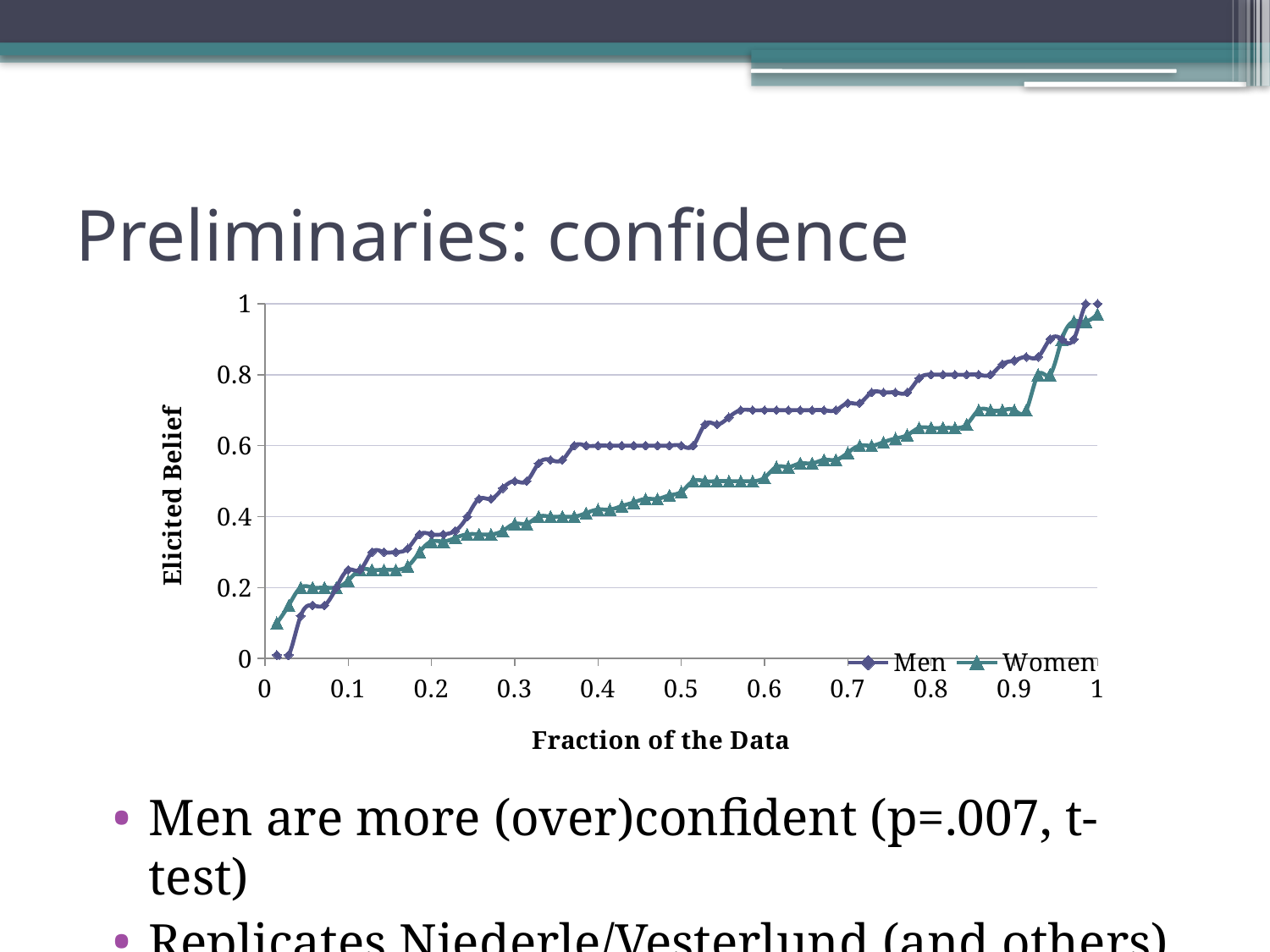
How many series does the legend list? 2 What are the two series named in the legend? Men and Women Is the elicited belief for Women at a fraction of the data of 0.5 greater or less than 0.6? less Is the elicited belief for Women at a fraction of the data of 0.9 greater or less than 0.8? less Do the values for the Women series rise or fall along the x axis? rise Do the values for the Men series rise or fall as the fraction of the data increases from 0 to 1? rise At a fraction of the data of 0.05, which series has the higher elicited belief, Men or Women? Women What kind of chart is shown on the slide? line chart At a fraction of the data of 0.5, which series has the higher elicited belief, Men or Women? Men Is the elicited belief for Men at a fraction of the data of 0.5 greater or less than 0.4? greater What is the title of the vertical axis? Elicited Belief At a fraction of the data of 0.3, which series has the higher elicited belief, Men or Women? Men